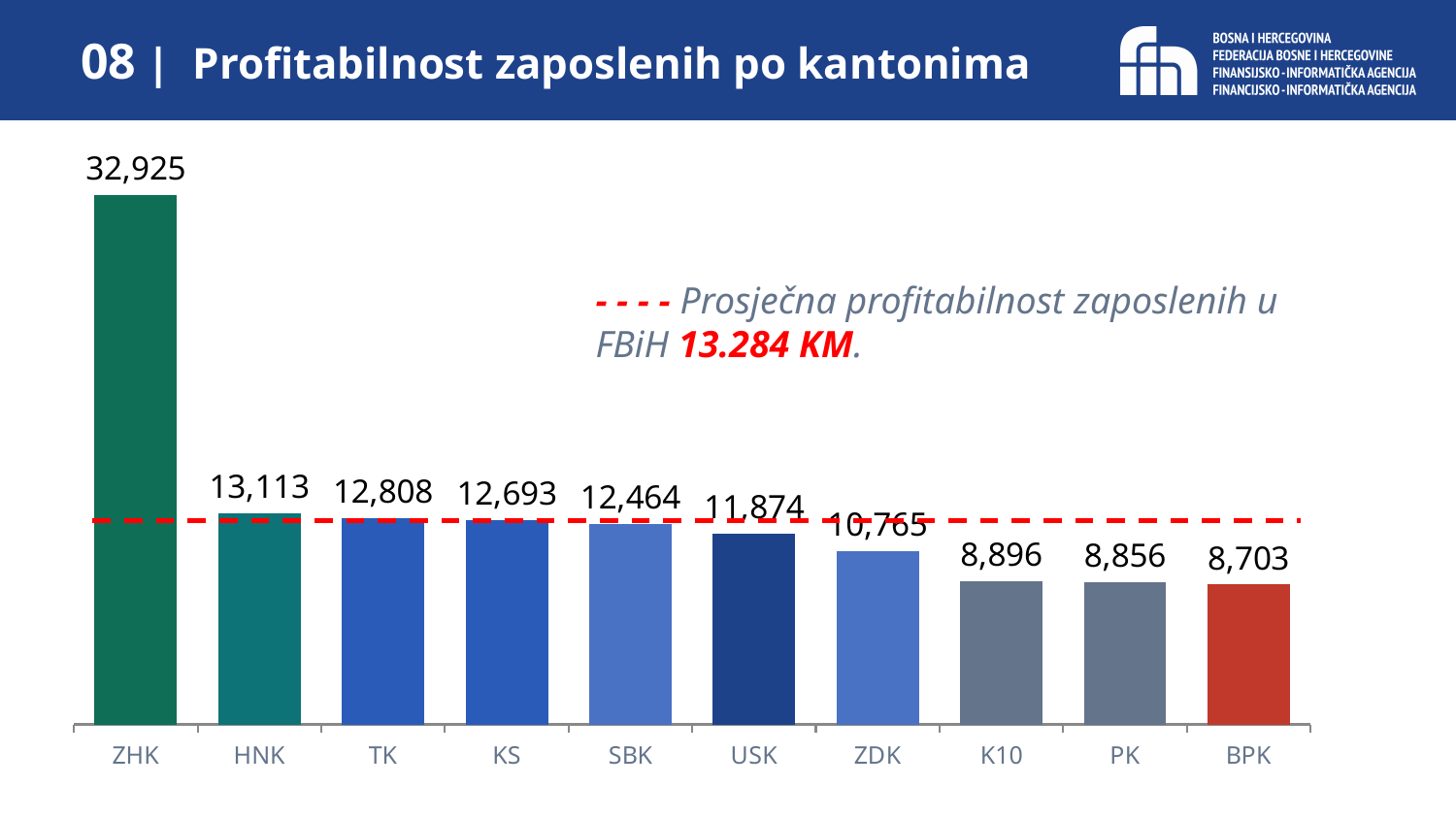
What kind of chart is shown on the slide? Bar chart What is the difference between the values for ZHK and HNK? 19,812 Do the values rise or fall from left to right along the x axis? Fall Which is larger, the value for TK or the value for KS? TK Which canton has the lowest value? BPK What is the difference between the values for ZDK and K10? 1,869 What value does the red dashed line represent, according to the text on the slide? 13.284 KM How many cantons are shown on the chart? 10 What is the value for BPK? 8,703 What is the value for USK? 11,874 Which canton has the highest value? ZHK What is the value for ZHK? 32,925